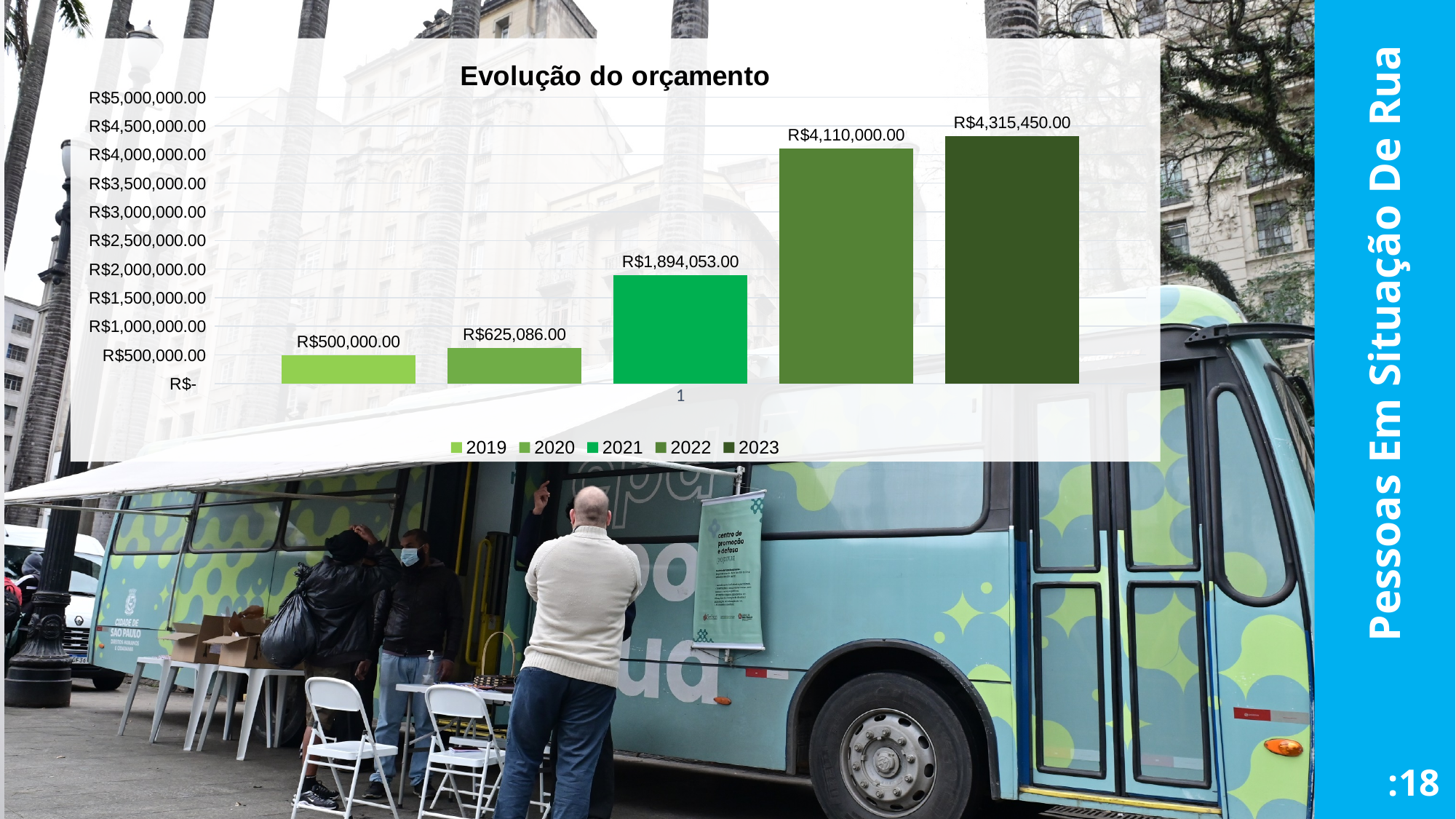
Which is larger, the value for 2021 or the value for 2022? 2022 What is the value for 2020? R$625,086.00 Which year has the lowest value? 2019 What is the difference between the values for 2023 and 2022? R$205,450.00 What is the value for 2019? R$500,000.00 Which year has the highest value? 2023 What type of chart is shown on the slide? bar chart Do the values rise or fall from 2019 to 2023? rise What is the value for 2022? R$4,110,000.00 What is the title of the chart? Evolução do orçamento What is the value for 2021? R$1,894,053.00 How many series does the legend list? 5